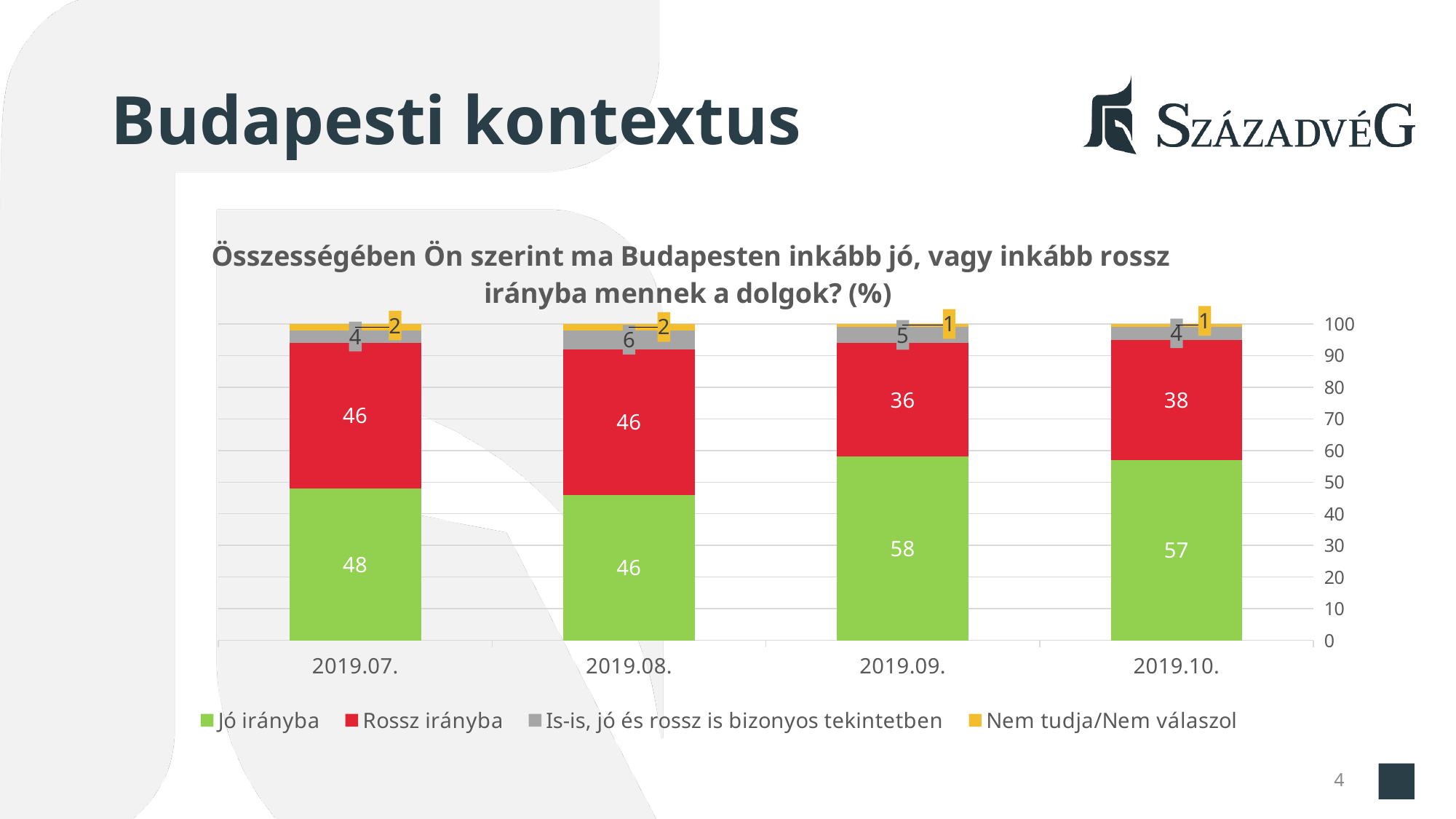
What is the difference between the "Jó irányba" values for 2019.09 and 2019.08? 12 What is the value for "Rossz irányba" in 2019.10? 38 What kind of chart is shown on the slide? stacked bar chart How many series does the legend list? 4 Which is larger in 2019.07: the "Jó irányba" value or the "Rossz irányba" value? Jó irányba What is the total of the stacked bar for 2019.10? 100 How many time periods (categories) are shown on the x axis? 4 Which series is shown in green in the legend? Jó irányba In which period is the "Rossz irányba" value lowest? 2019.09. What is the value for "Jó irányba" in 2019.09? 58 What is the value for "Is-is, jó és rossz is bizonyos tekintetben" in 2019.08? 6 In which period is the "Jó irányba" value highest? 2019.09.